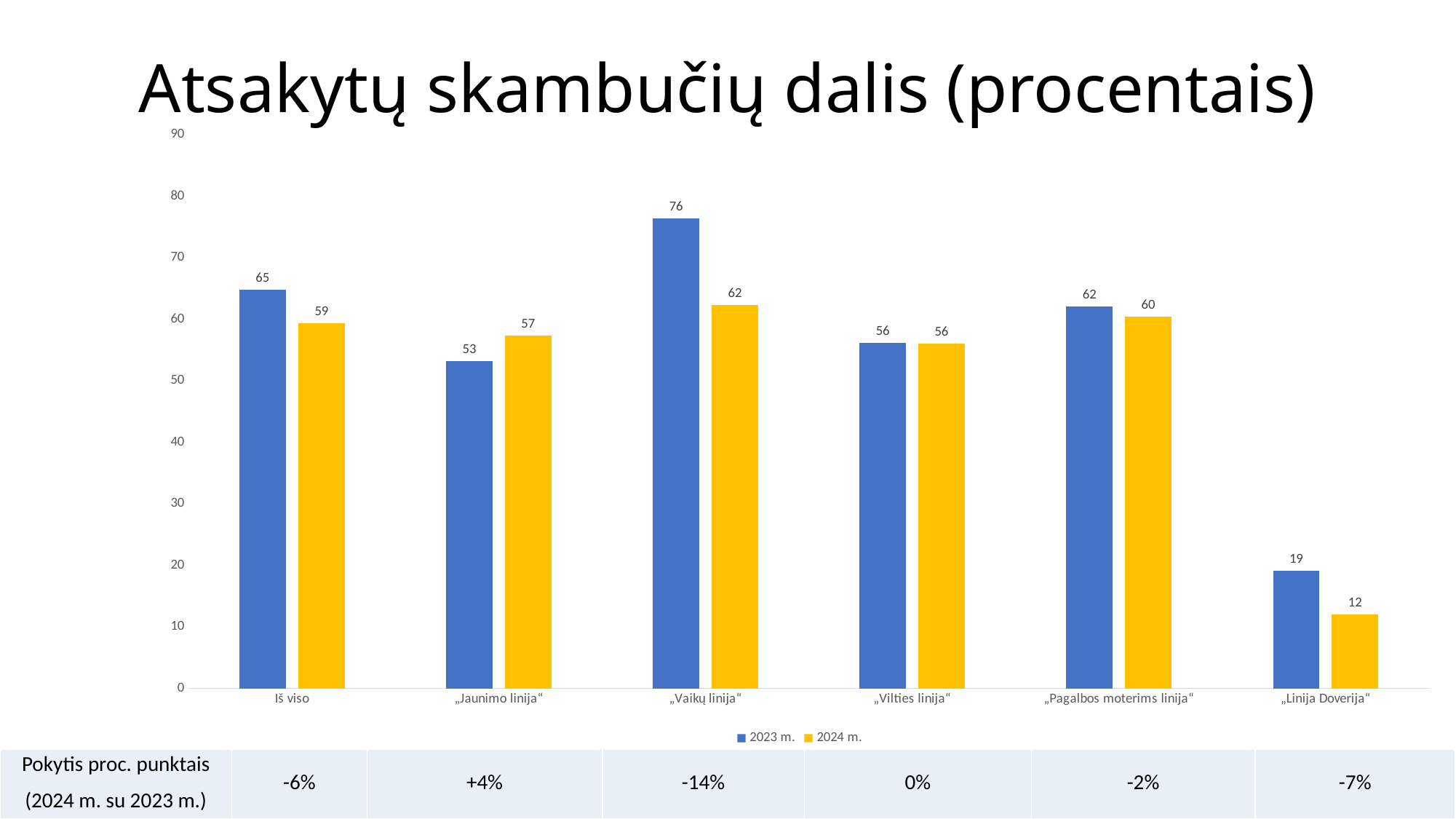
How many series does the legend list? 2 What is the value for „Jaunimo linija“ in the 2024 m. series? 57 Is the 2023 m. value for Iš viso greater or less than 60? greater What is the difference between the 2023 m. and 2024 m. values for „Vaikų linija“? 14 What kind of chart is shown on the slide? bar chart How many categories are shown on the x axis? 6 What is the value for „Linija Doverija“ in the 2024 m. series? 12 Which category has the lowest value in the 2024 m. series? „Linija Doverija“ Which is larger for „Jaunimo linija“: the 2023 m. value or the 2024 m. value? 2024 m. What is the title of the chart? Atsakytų skambučių dalis (procentais) Which category has the highest value in the 2023 m. series? „Vaikų linija“ What is the value for „Vaikų linija“ in the 2023 m. series? 76